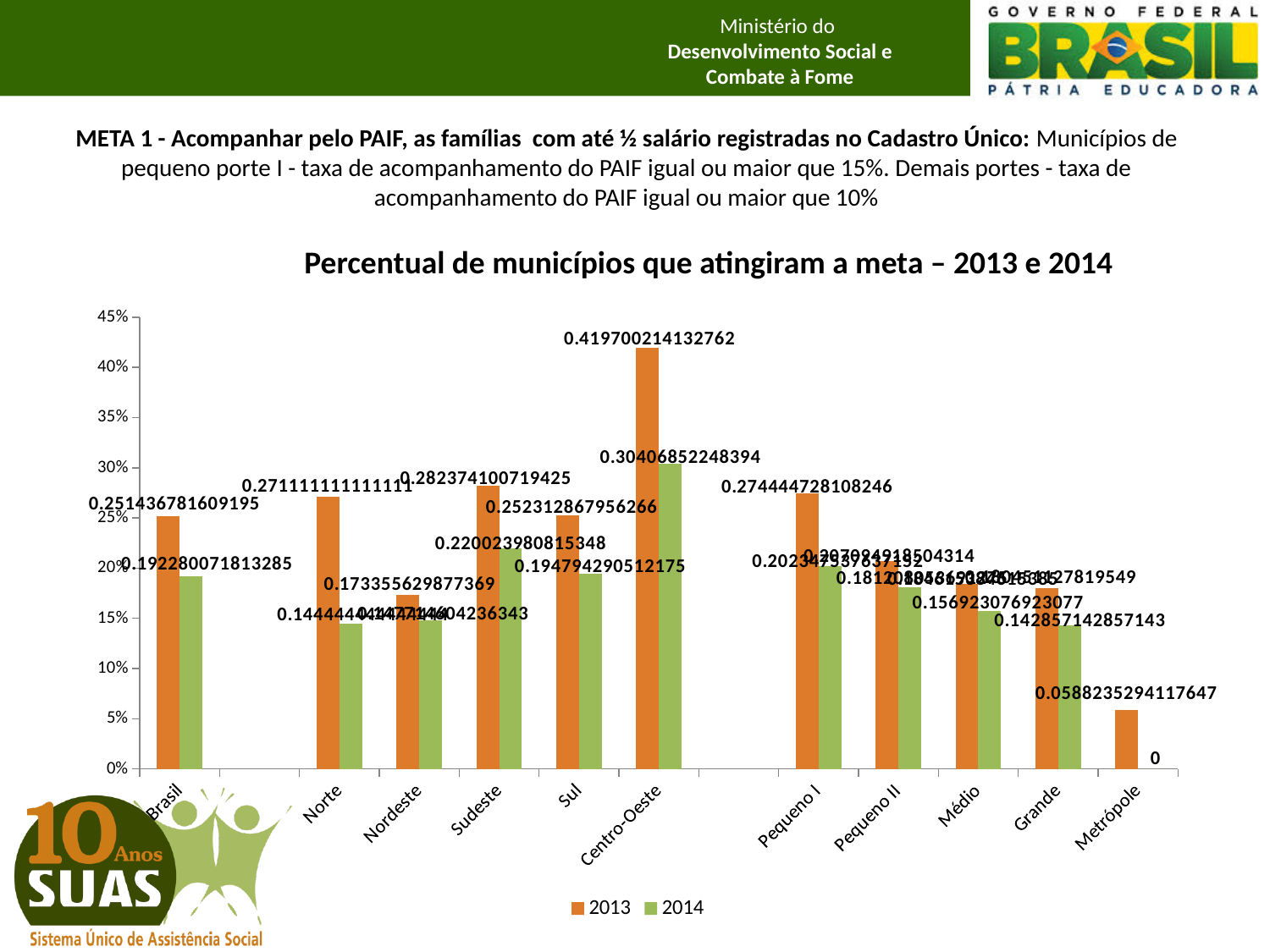
What type of chart is shown on the slide? bar chart What is the difference between the 2013 and 2014 values for Metrópole? 0.0588235294117647 What is the value for Centro-Oeste in 2013? 0.419700214132762 For Brasil, which year has the larger value, 2013 or 2014? 2013 How many categories are shown on the x axis? 11 Which category has the highest value for 2013? Centro-Oeste What is the value for Sudeste in 2013? 0.282374100719425 Is the value for Centro-Oeste in 2013 greater or less than 40%? greater How many series does the legend list? 2 Which category has the lowest value for 2014? Metrópole What is the value for Metrópole in 2014? 0 What is the value for Grande in 2014? 0.142857142857143